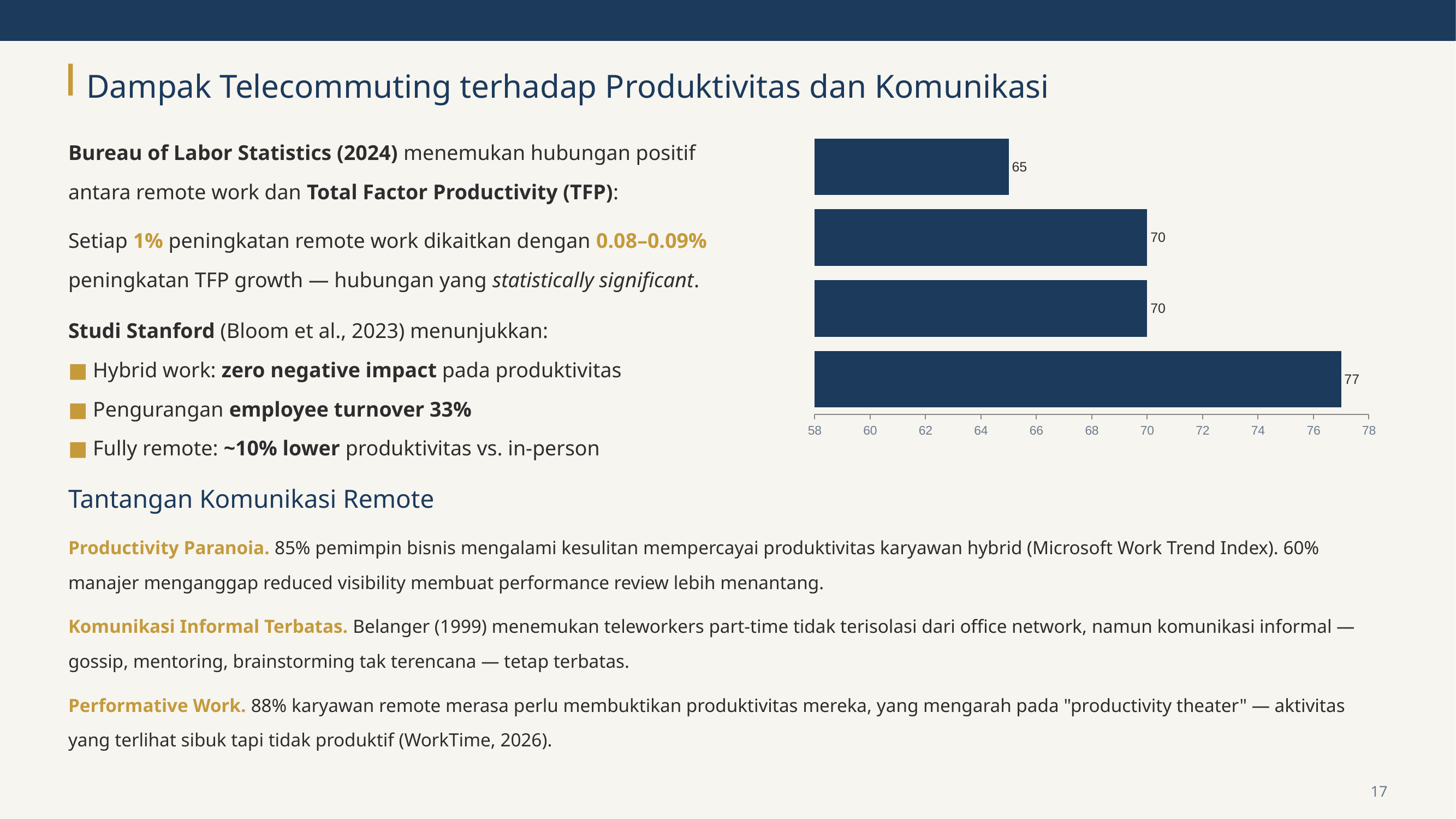
What is the value shown on the second bar from the top of the chart? 70 What is the lowest value shown in the chart? 65 What is the difference between the third bar's value and the top bar's value in the chart? 5 What is the difference between the bottom bar's value and the top bar's value in the chart? 12 What is the lowest tick value shown on the horizontal axis of the chart? 58 How many bars does the chart on the slide contain? 4 Is the value of the bottom bar in the chart greater or less than 76? greater What type of chart is shown on the right side of the slide? bar chart Which bar is longer in the chart, the top bar or the bottom bar? the bottom bar What is the value shown on the top bar of the chart? 65 What is the value shown on the bottom bar of the chart? 77 What is the highest value shown in the chart? 77